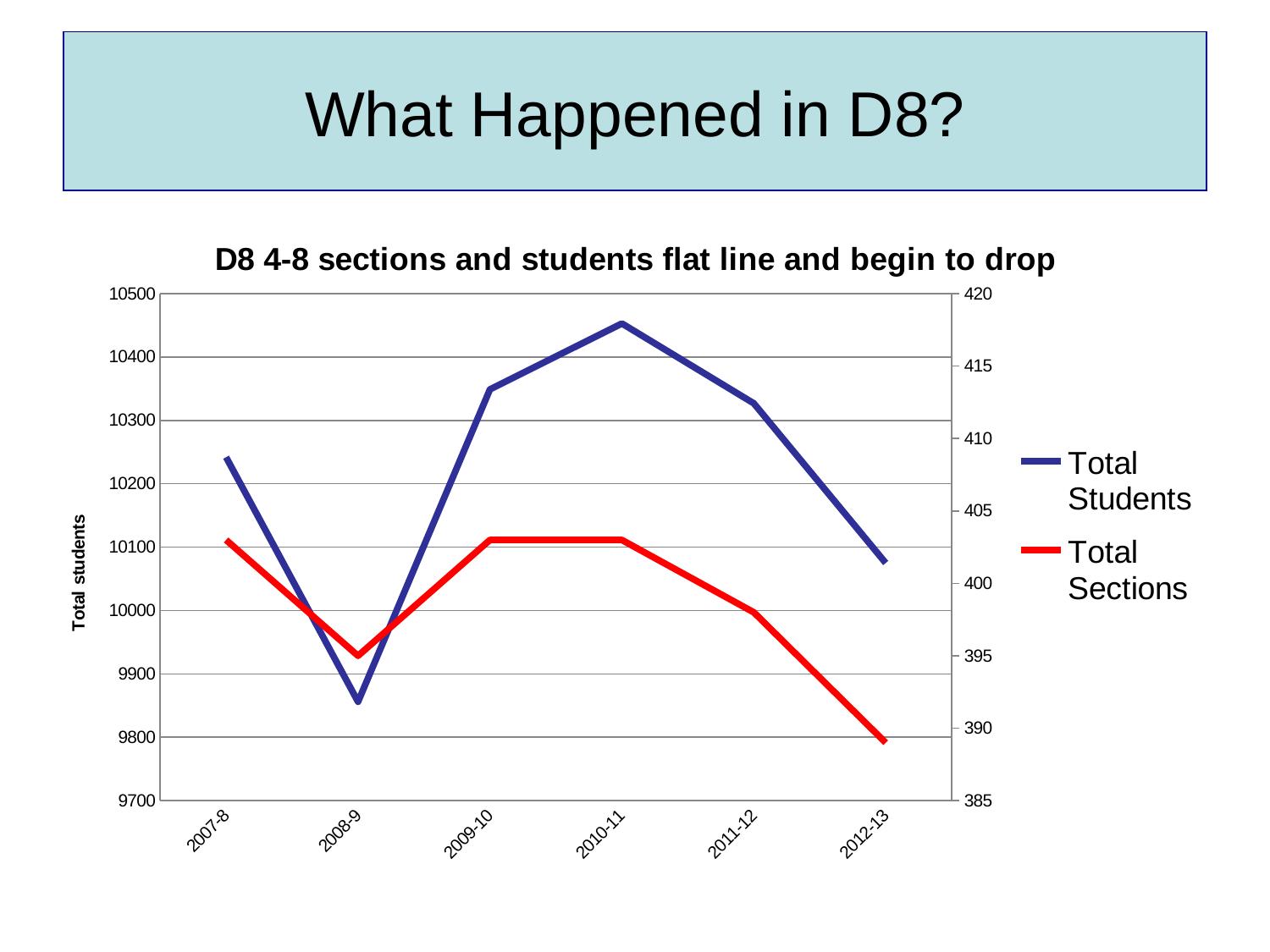
How many series does the legend list? 2 Do the Total Students values rise or fall from 2010-11 to 2012-13? fall Is the Total Students value for 2010-11 greater or less than 10400? greater In which school year is Total Students lowest? 2008-9 What kind of chart is shown on the slide? line chart In which school year is Total Students highest? 2010-11 How many school years are plotted along the x axis? 6 Which is larger, Total Students in 2007-8 or Total Students in 2012-13? 2007-8 Is the Total Sections value for 2008-9 greater or less than 400? less Is the Total Students value for 2008-9 greater or less than 9900? less In which school year is Total Sections lowest? 2012-13